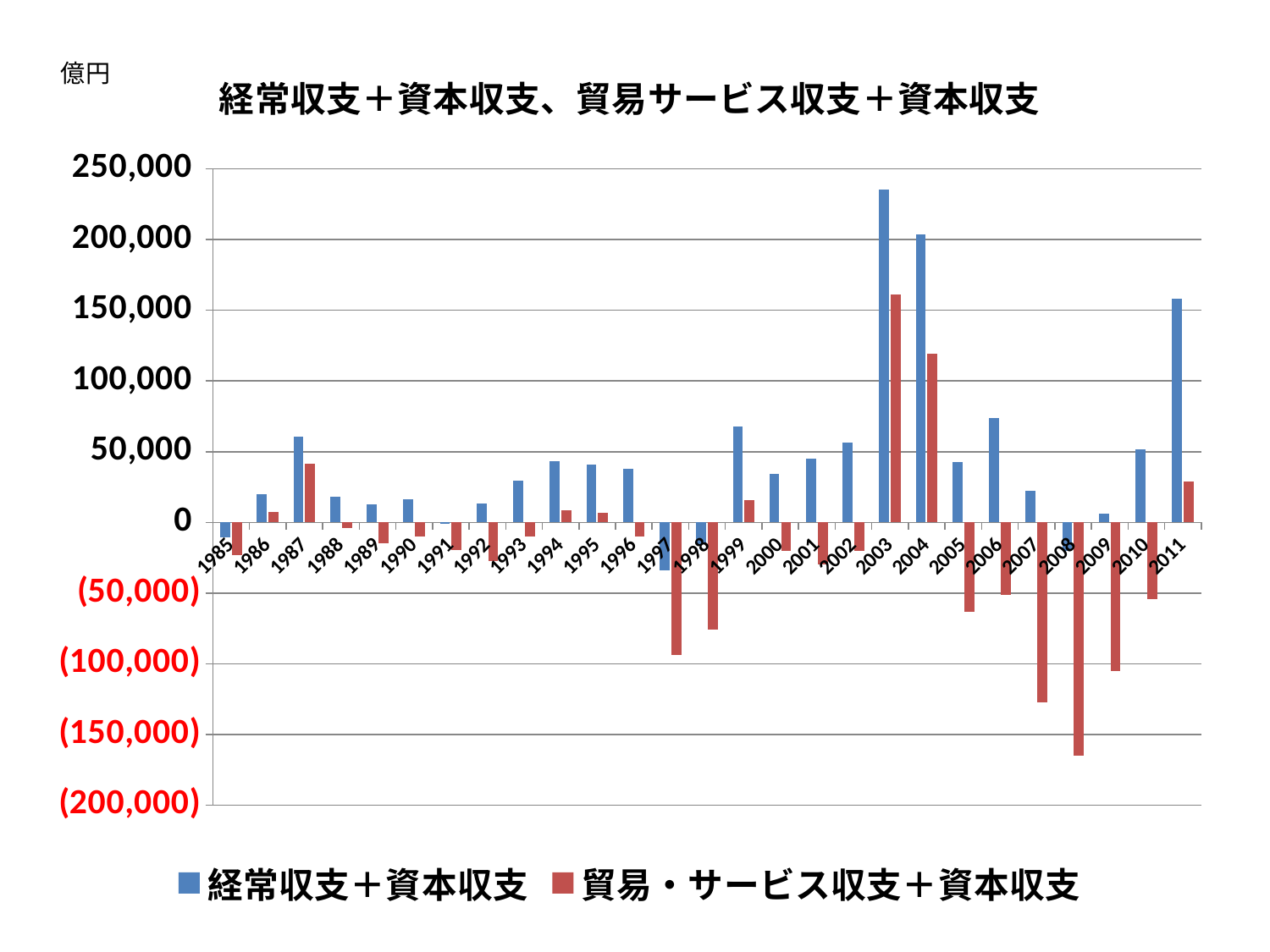
How many series does the legend list? 2 Is the value for 経常収支＋資本収支 in 2003 greater or less than 200,000? greater What kind of chart is shown on the slide? bar chart How many years are shown on the x axis? 27 Is the value for 経常収支＋資本収支 in 2006 greater or less than 50,000? greater In which year is the 貿易・サービス収支＋資本収支 series highest? 2003 In which year is the 経常収支＋資本収支 series highest? 2003 In 2011, which series has the larger value, 経常収支＋資本収支 or 貿易・サービス収支＋資本収支? 経常収支＋資本収支 Is the value for 貿易・サービス収支＋資本収支 in 2007 greater or less than (100,000)? less What unit is shown at the top left of the chart? 億円 In which year is the 貿易・サービス収支＋資本収支 series lowest? 2008